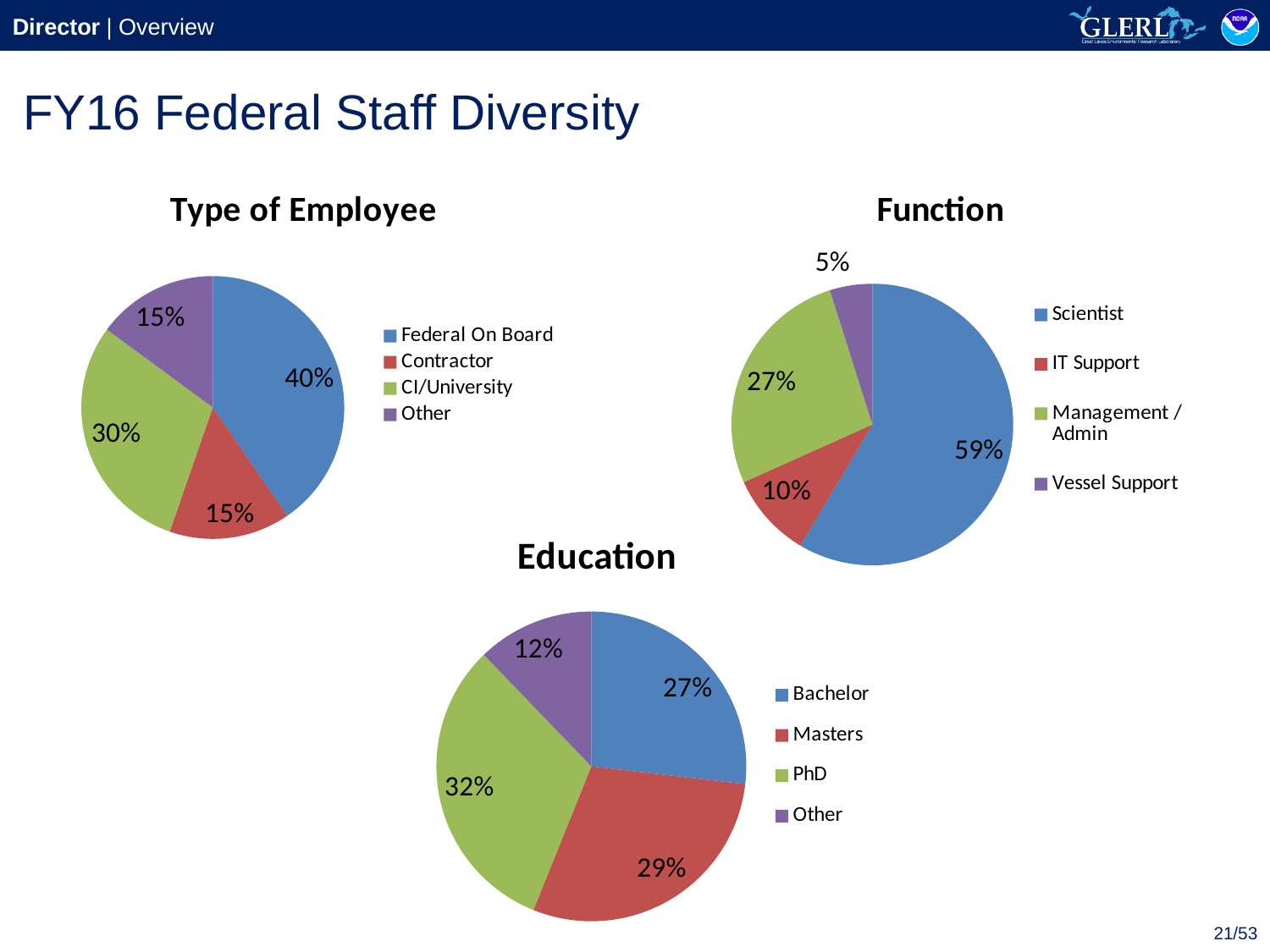
In the Education chart, what is the difference between the Masters and Bachelor shares? 2% In the Education chart, which category has the largest share? PhD In the Function chart, which category has the smallest share? Vessel Support In the Type of Employee chart, what share is Federal On Board? 40% In the Type of Employee chart, what is the difference between the Federal On Board and Contractor shares? 25% In the Type of Employee chart, what share is CI/University? 30% In the Education chart, what share is PhD? 32% In the Type of Employee chart, which category has the largest share? Federal On Board In the Function chart, what share is Vessel Support? 5% How many charts are on the slide, and what type are they? Three pie charts In the Function chart, which is larger, IT Support or Management / Admin? Management / Admin In the Function chart, what share is Scientist? 59%